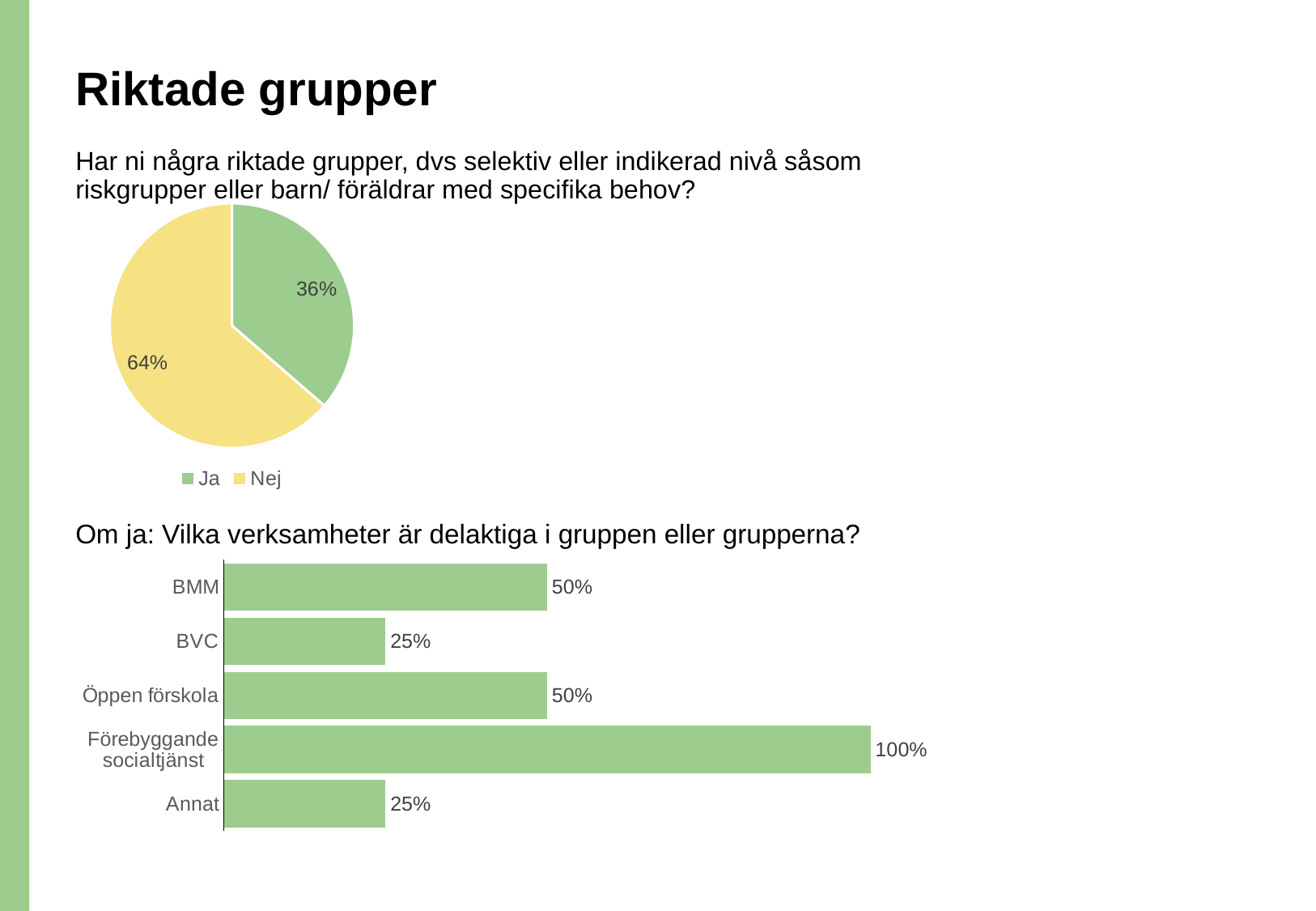
In the bar chart at the bottom of the slide, what is the value for Öppen förskola? 50% What kind of chart is the chart at the bottom of the slide ("Om ja: Vilka verksamheter är delaktiga i gruppen eller grupperna?")? Bar chart In the bar chart at the bottom of the slide, what is the value for Förebyggande socialtjänst? 100% In the pie chart at the top of the slide, how many entries does the legend list? 2 In the bar chart at the bottom of the slide, which is larger, the value for BMM or the value for Annat? BMM In the bar chart at the bottom of the slide, how many categories are shown? 5 In the bar chart at the bottom of the slide, what is the difference between the values for Förebyggande socialtjänst and BMM? 50% In the bar chart at the bottom of the slide, what is the value for BVC? 25% In the pie chart at the top of the slide, what share of responses is "Nej"? 64% In the pie chart at the top of the slide, which slice is larger, "Ja" or "Nej"? Nej In the pie chart at the top of the slide, what share of responses is "Ja"? 36% In the bar chart at the bottom of the slide, which category has the highest value? Förebyggande socialtjänst